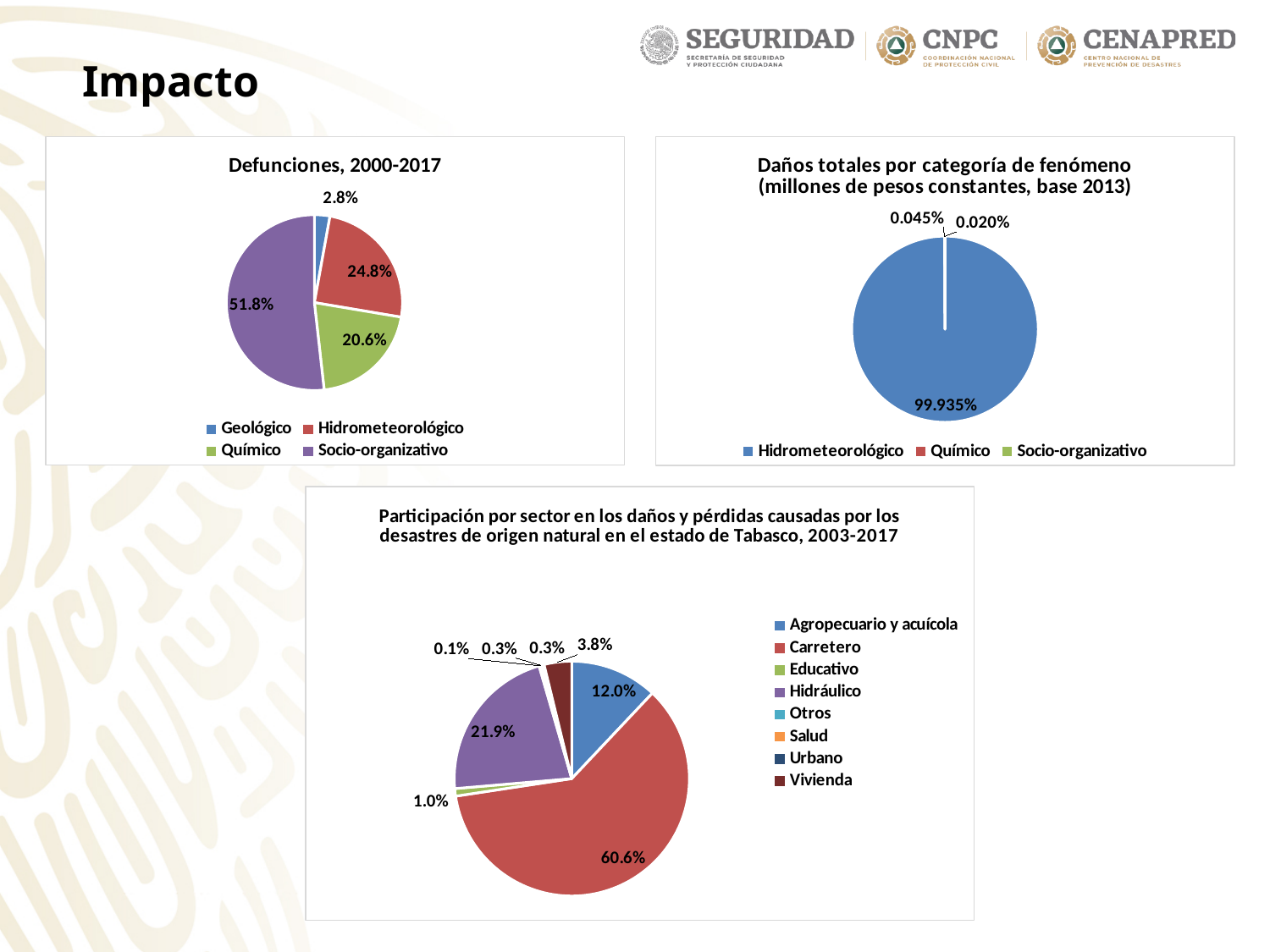
In the 'Participación por sector' chart for Tabasco, what is the difference between the Carretero and Hidráulico shares? 38.7% In the 'Defunciones, 2000-2017' chart, what share of deaths is attributed to Socio-organizativo? 51.8% In the 'Defunciones, 2000-2017' chart, what percentage is shown for Hidrometeorológico? 24.8% In the 'Defunciones, 2000-2017' chart, which category has the smallest slice? Geológico In the 'Daños totales por categoría de fenómeno' chart, what percentage is shown for Hidrometeorológico? 99.935% In the 'Defunciones, 2000-2017' chart, how many categories does the legend list? 4 In the 'Daños totales por categoría de fenómeno' chart, which category accounts for the largest share? Hidrometeorológico What type of chart is 'Daños totales por categoría de fenómeno'? Pie chart In the 'Defunciones, 2000-2017' chart, what is the difference between the Hidrometeorológico and Químico shares? 4.2% In the 'Participación por sector' chart for Tabasco, how many sectors does the legend list? 8 In the 'Participación por sector' chart for Tabasco, what share is attributed to Carretero? 60.6% In the 'Participación por sector' chart for Tabasco, which is larger: Hidráulico or Agropecuario y acuícola? Hidráulico